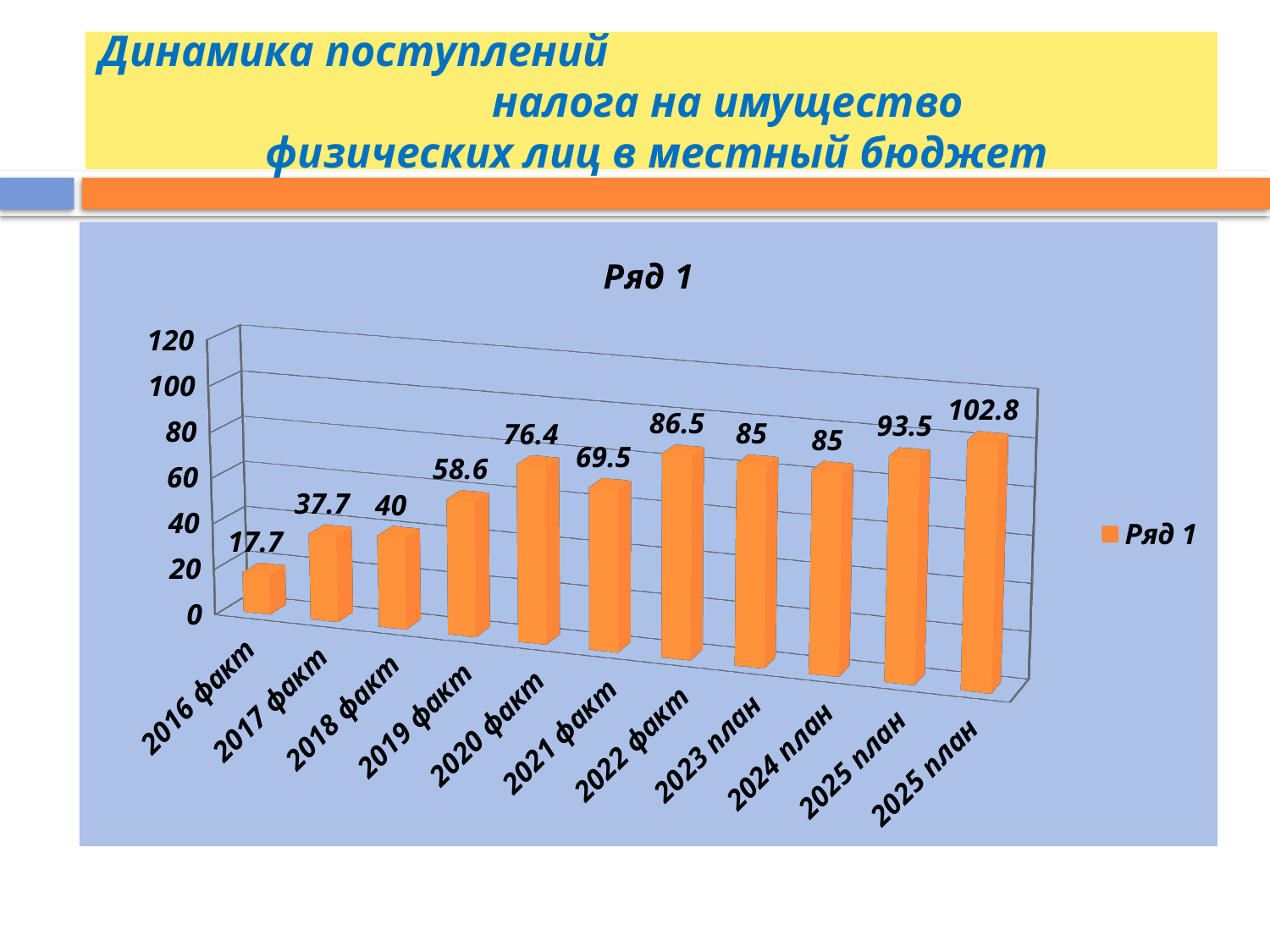
What type of chart is shown on the slide? Bar chart What is the value of the highest bar, the last one on the right? 102.8 What is the difference between the values for 2019 факт and 2018 факт? 18.6 What is the value for 2016 факт? 17.7 How many series does the legend list? 1 What is the value for 2020 факт? 76.4 Which is larger, the value for 2020 факт or 2021 факт? 2020 факт Which category has the lowest value? 2016 факт What is the value for 2023 план? 85 What is the value for 2022 факт? 86.5 How many bars are plotted in the chart? 11 What is the title shown above the chart? Ряд 1